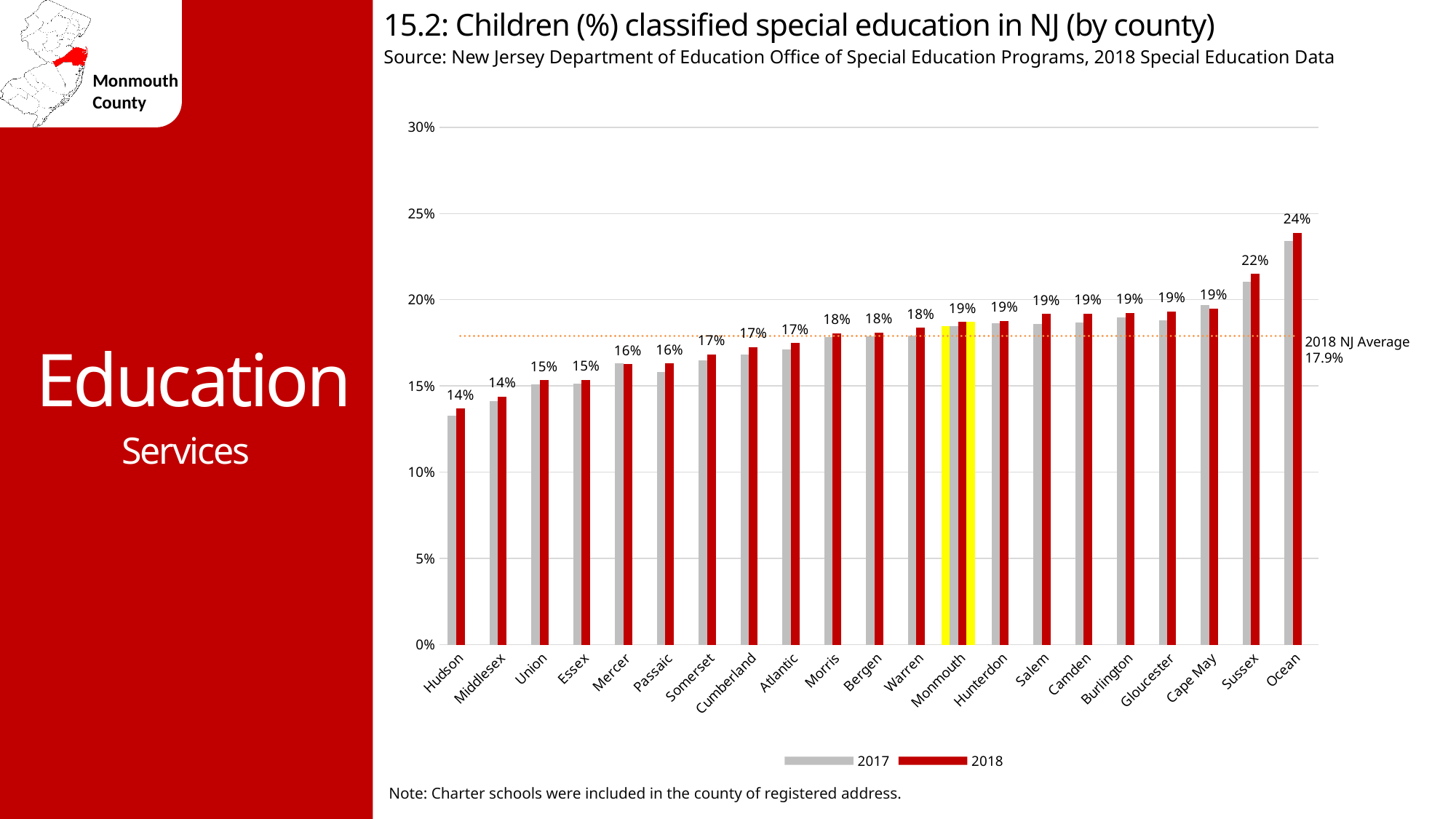
Is the 2017 value for Hudson greater or less than 15%? less Is the 2017 value for Ocean greater or less than 20%? greater How many counties are shown on the x axis? 21 What is the 2018 value for Ocean? 24% What is the 2018 value for Monmouth? 19% What is the 2018 value for Sussex? 22% Which county has the highest 2018 value? Ocean Which has the larger 2018 value, Sussex or Cape May? Sussex What is the 2018 NJ average shown by the dotted line? 17.9% How many series does the legend list? 2 What is the difference between the 2018 values for Ocean and Hudson? 10 percentage points What kind of chart is shown? bar chart